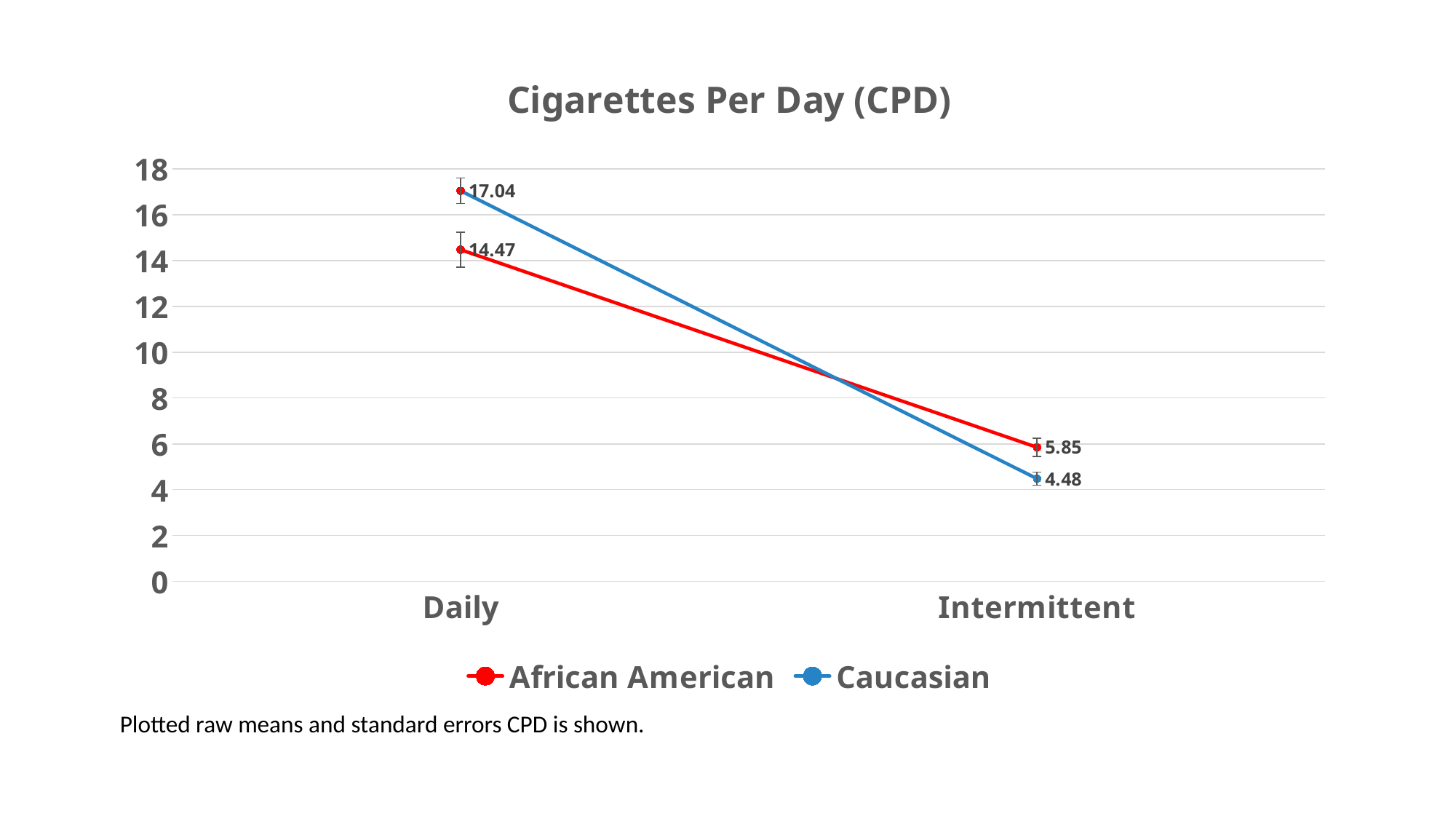
What is the Cigarettes Per Day value for Caucasian smokers in the Intermittent category? 4.48 Which series has the higher value in the Intermittent category? African American How many series does the legend list? 2 How many categories are shown on the x axis? 2 What is the difference between the Caucasian and African American values in the Daily category? 2.57 What is the difference between the African American and Caucasian values in the Intermittent category? 1.37 What is the title of the chart? Cigarettes Per Day (CPD) What is the Cigarettes Per Day value for African American smokers in the Daily category? 14.47 What is the Cigarettes Per Day value for African American smokers in the Intermittent category? 5.85 Which series has the higher value in the Daily category? Caucasian Do the values for the Caucasian series rise or fall from Daily to Intermittent? fall What is the Cigarettes Per Day value for Caucasian smokers in the Daily category? 17.04